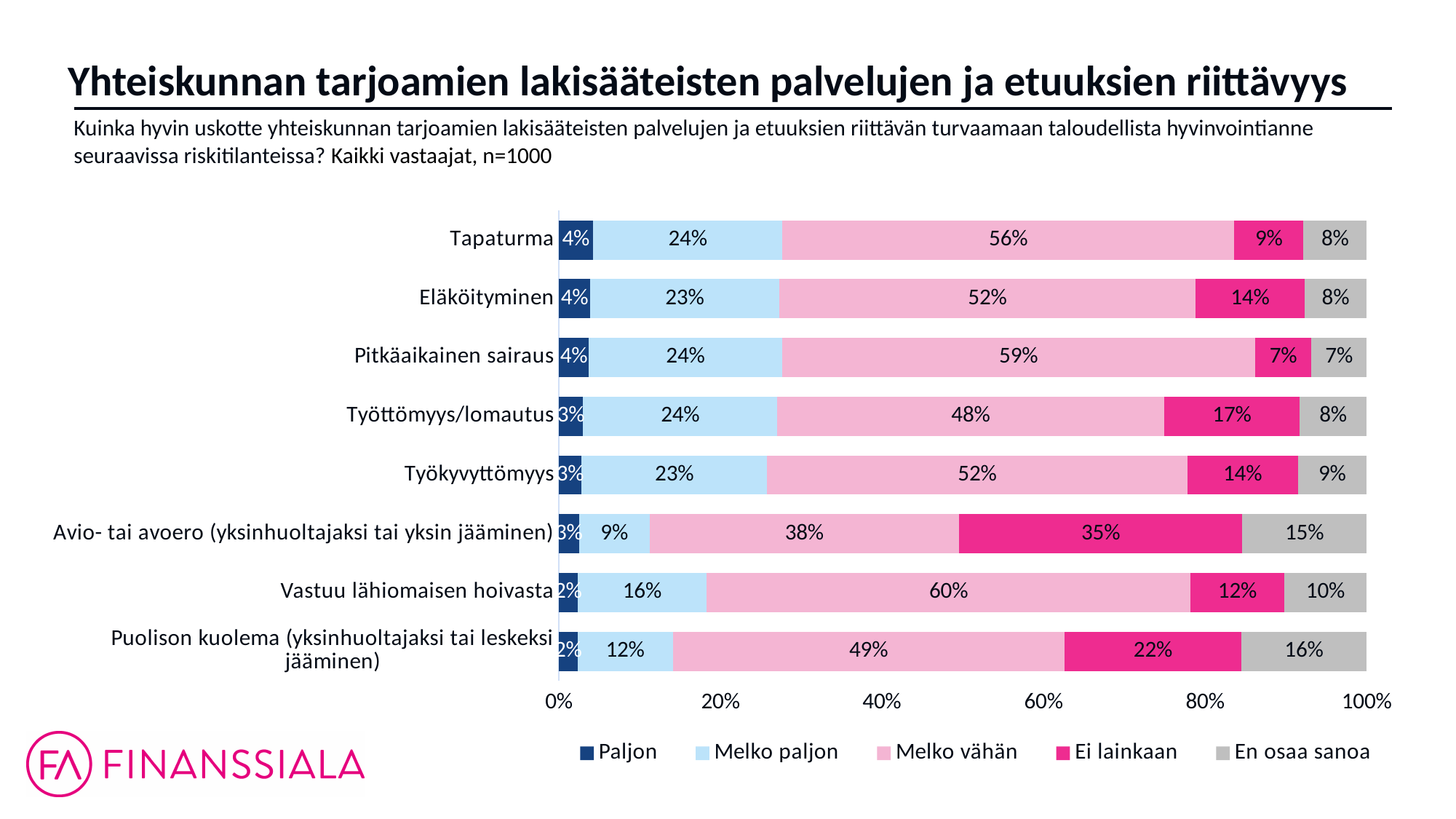
How many categories (risk situations) are shown in the chart? 8 What is the 'Melko vähän' value for Tapaturma? 56% What is the 'Melko paljon' value for Työttömyys/lomautus? 24% Which is larger: the 'En osaa sanoa' value for Puolison kuolema or for Avio- tai avoero? Puolison kuolema (yksinhuoltajaksi tai leskeksi jääminen) What is the 'Ei lainkaan' value for Puolison kuolema (yksinhuoltajaksi tai leskeksi jääminen)? 22% What kind of chart is shown on the slide? Stacked bar chart What is the 'En osaa sanoa' value for Vastuu lähiomaisen hoivasta? 10% Which category has the highest 'Melko vähän' value? Vastuu lähiomaisen hoivasta Which category has the lowest 'Melko paljon' value? Avio- tai avoero (yksinhuoltajaksi tai yksin jääminen) How many series does the legend list? 5 What is the difference between the 'Ei lainkaan' values for Työttömyys/lomautus and Pitkäaikainen sairaus? 10% Which category has the highest 'Ei lainkaan' value? Avio- tai avoero (yksinhuoltajaksi tai yksin jääminen)